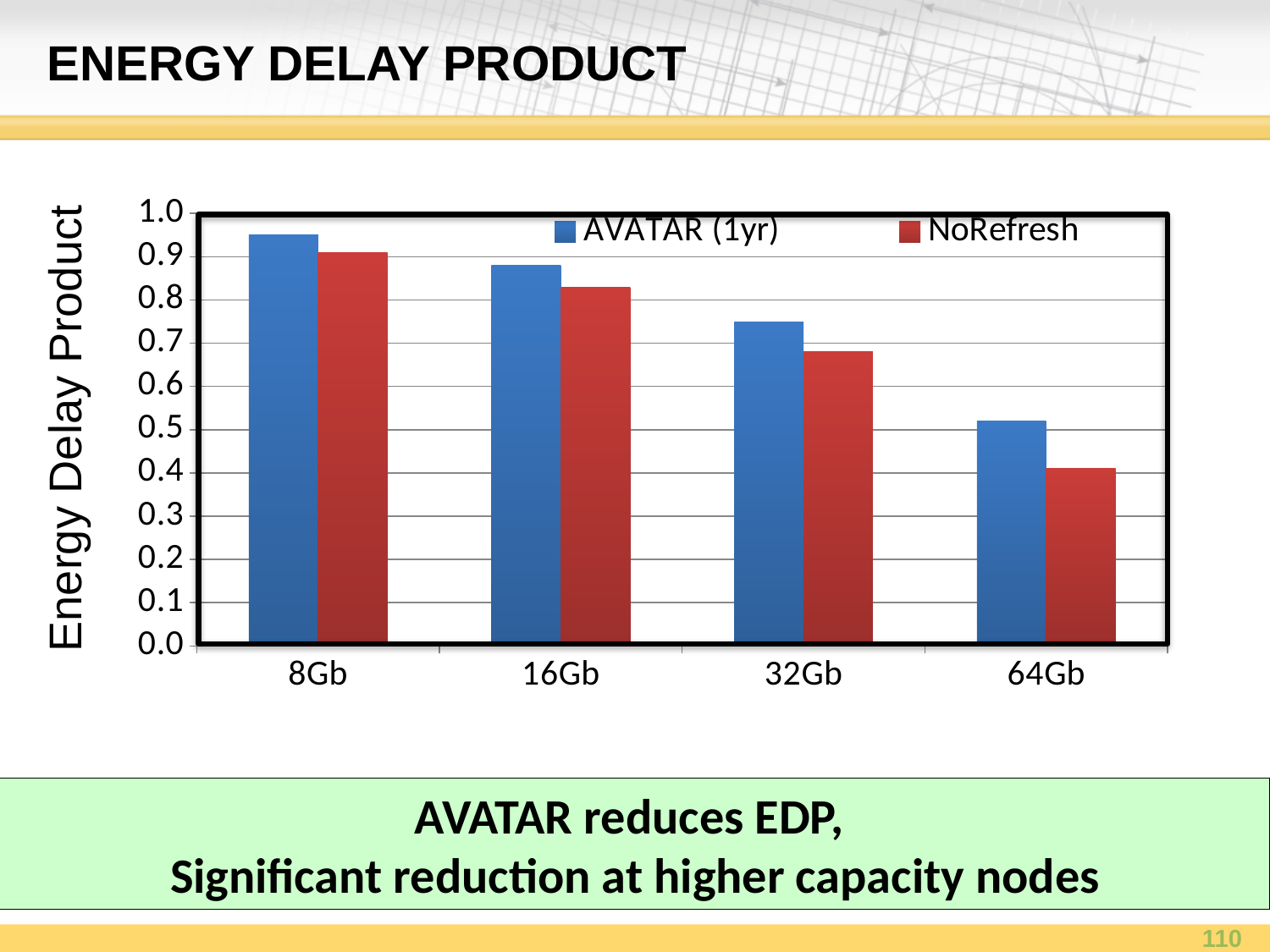
Which capacity has the lowest NoRefresh value? 64Gb Is the NoRefresh value for 64Gb greater or less than 0.5? less What kind of chart is shown on the slide? bar chart Is the AVATAR (1yr) value for 32Gb greater or less than 0.7? greater Do the NoRefresh values rise or fall as capacity increases from 8Gb to 64Gb? fall At 64Gb, which is larger: AVATAR (1yr) or NoRefresh? AVATAR (1yr) Is the AVATAR (1yr) value for 8Gb greater or less than 0.9? greater Which capacity has the highest AVATAR (1yr) value? 8Gb At 32Gb, which is larger: AVATAR (1yr) or NoRefresh? AVATAR (1yr) How many series does the legend list? 2 What is the label on the y axis of the chart? Energy Delay Product How many capacity categories are shown on the x axis? 4